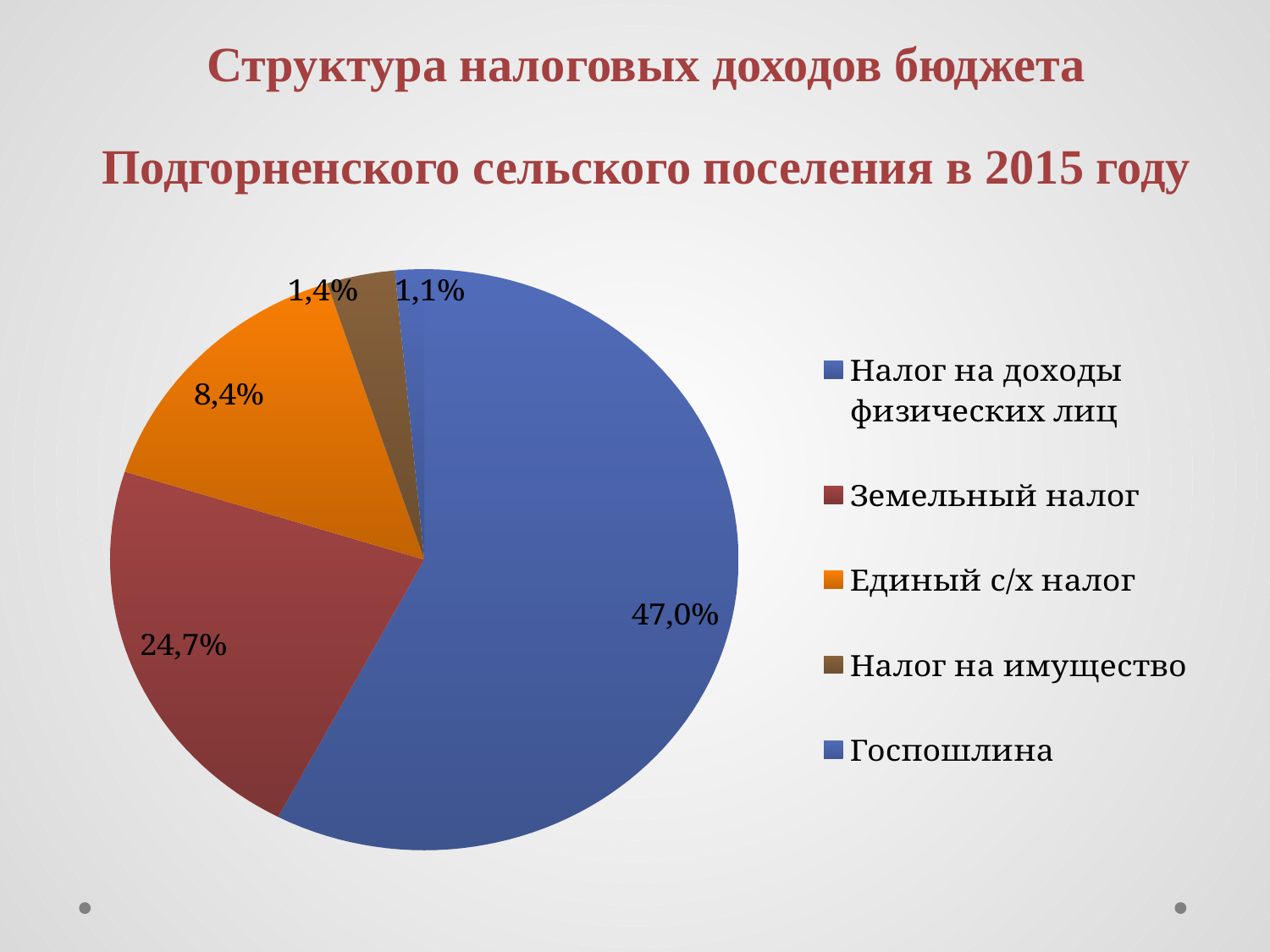
What kind of chart is shown on the slide? pie chart Which category has the smallest slice of the pie? Госпошлина How many categories does the legend list? 5 Which category has the largest slice of the pie? Налог на доходы физических лиц What is the value shown for Земельный налог? 24,7% What is the difference between the values for Налог на доходы физических лиц and Земельный налог? 22,3% Which is larger, Земельный налог or Единый с/х налог? Земельный налог What is the value shown for Налог на имущество? 1,4% What colour is the slice for Единый с/х налог? orange What is the value shown for Единый с/х налог? 8,4% What is the value shown for Госпошлина? 1,1% What share of the pie does Налог на доходы физических лиц have? 47,0%